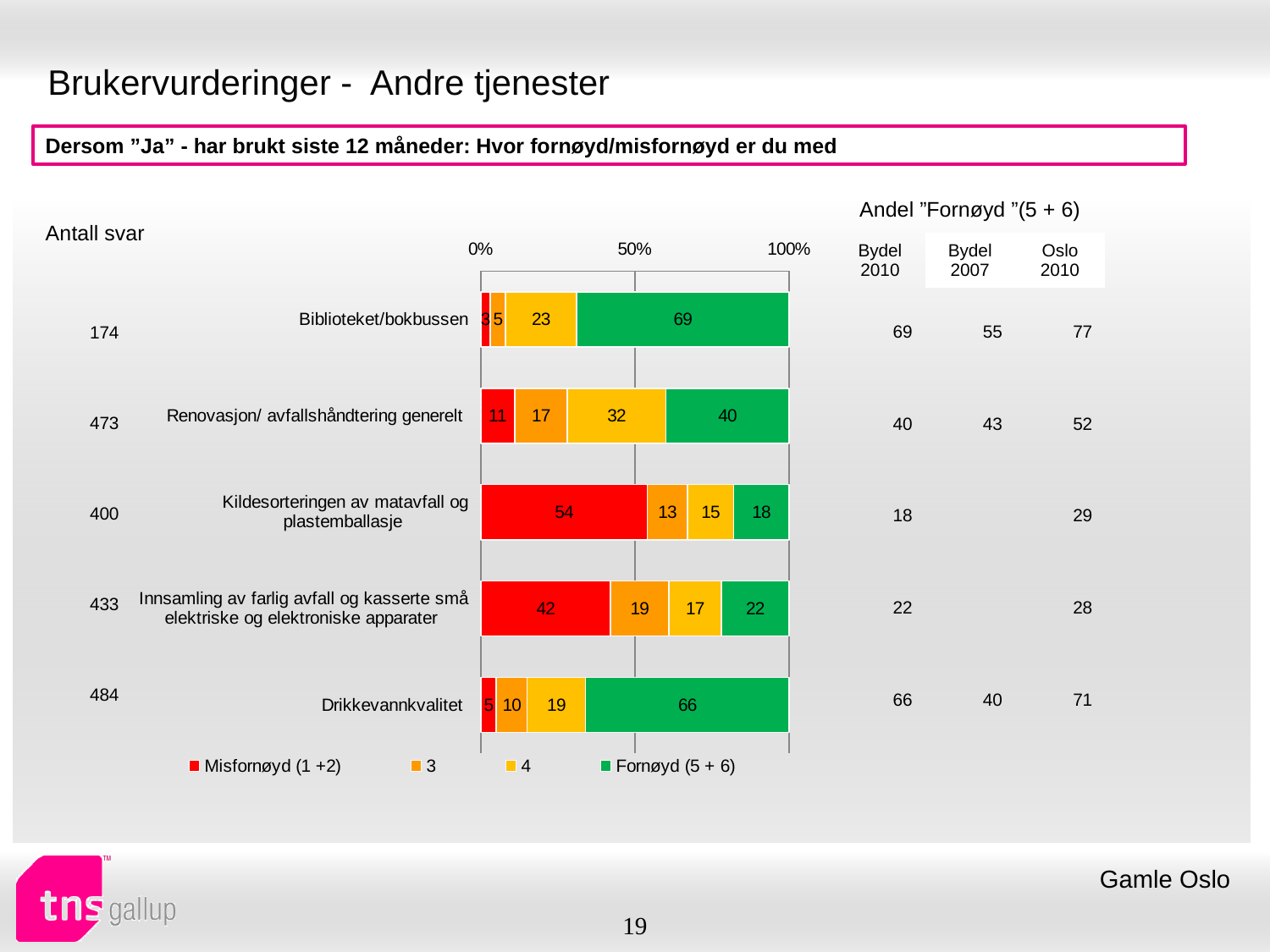
What is the value of the Misfornøyd (1 +2) segment for Kildesorteringen av matavfall og plastemballasje? 54 What is the difference between the Fornøyd (5 + 6) values for Drikkevannkvalitet and Renovasjon/ avfallshåndtering generelt? 26 Which category has the lowest Fornøyd (5 + 6) value? Kildesorteringen av matavfall og plastemballasje How many series does the legend list? 4 Which has the larger Misfornøyd (1 +2) value: Kildesorteringen av matavfall og plastemballasje or Innsamling av farlig avfall og kasserte små elektriske og elektroniske apparater? Kildesorteringen av matavfall og plastemballasje What kind of chart is shown on the slide? Stacked bar chart How many categories are shown in the chart? 5 What is the total of the stacked bar for Drikkevannkvalitet? 100 What is the value of the '4' segment for Renovasjon/ avfallshåndtering generelt? 32 Which category has the highest Fornøyd (5 + 6) value? Biblioteket/bokbussen What is the value of the Fornøyd (5 + 6) segment for Biblioteket/bokbussen? 69 What is the first entry in the chart legend? Misfornøyd (1 +2)